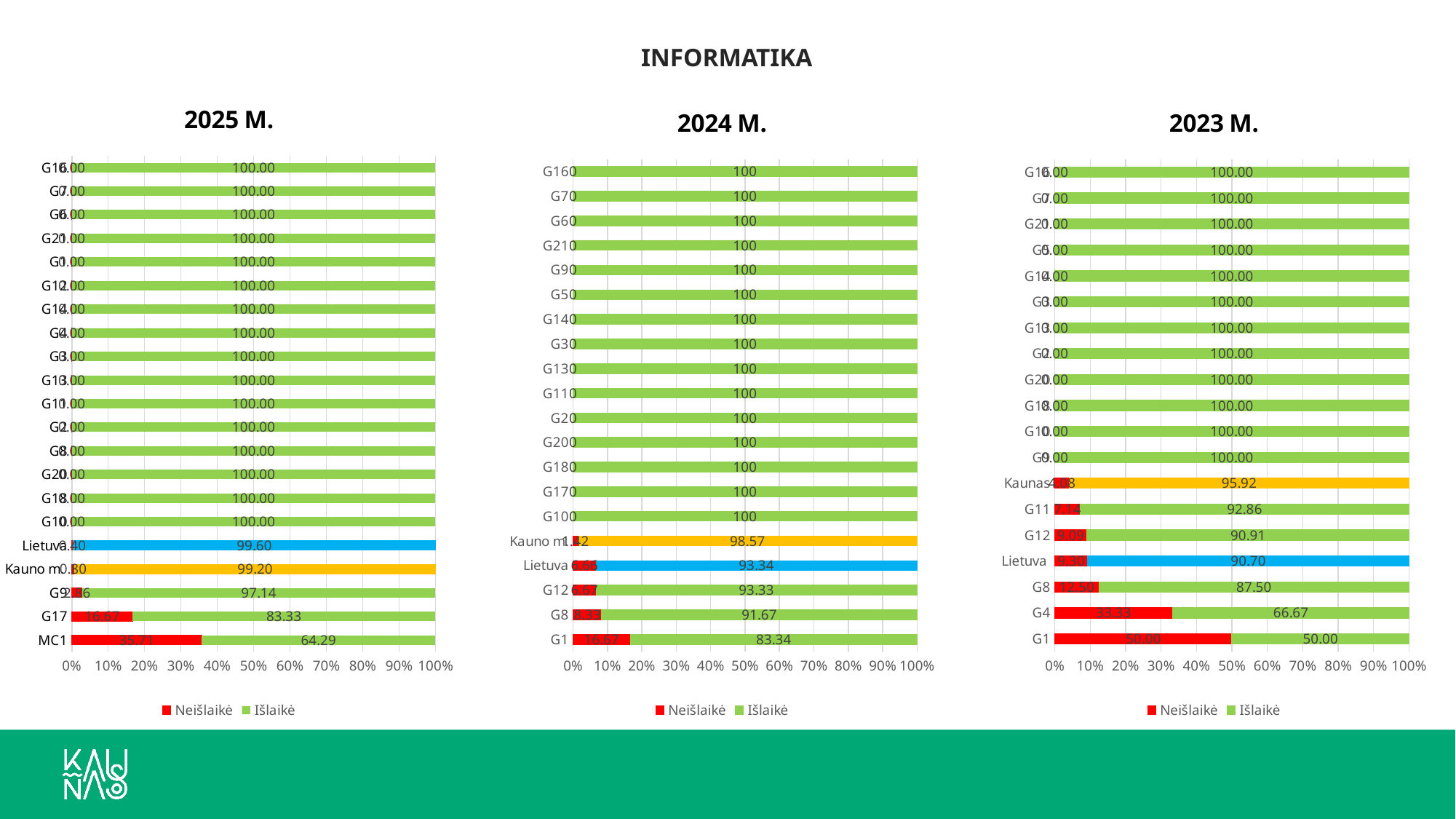
In the 2024 M. chart, what is the Neišlaikė value for G8? 8.33 In the 2023 M. chart, what is the Išlaikė value for Lietuva? 90.70 In the 2024 M. chart, what is the Išlaikė value for Kauno m.? 98.57 In the 2025 M. chart, which category has the lowest Išlaikė value? MC1 What kind of chart is the 2023 M. chart? Stacked bar chart In the 2023 M. chart, which category has the highest Neišlaikė value? G1 How many series does the legend of the 2024 M. chart list? 2 In the 2023 M. chart, what is the Neišlaikė value for G4? 33.33 In the 2025 M. chart, what is the Išlaikė value for MC1? 64.29 In the 2023 M. chart, what is the difference between the Išlaikė values for G8 and G4? 20.83 In the 2024 M. chart, which is larger, the Išlaikė value for G12 or for G1? G12 In the 2025 M. chart, what is the Neišlaikė value for G17? 16.67